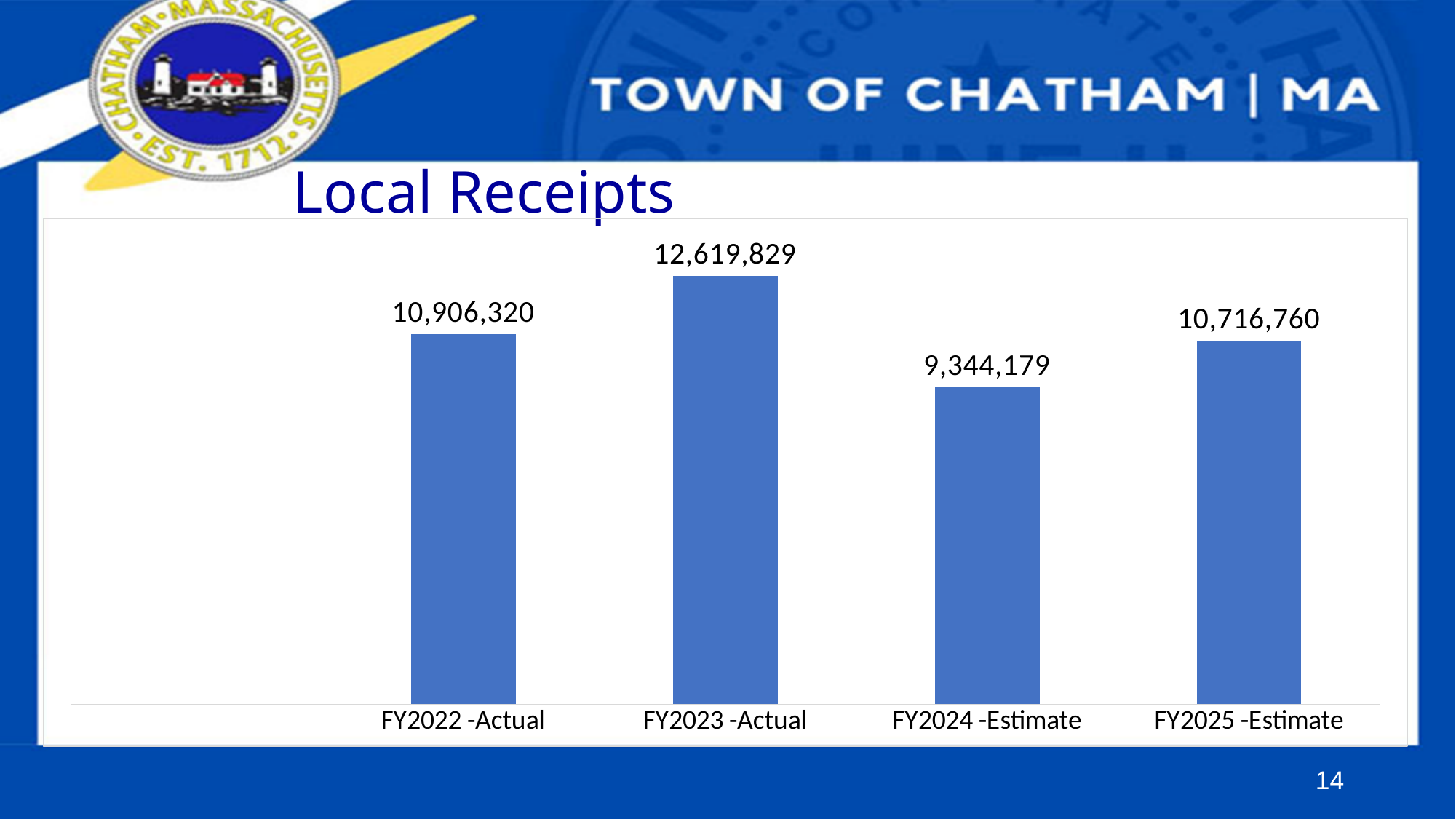
What kind of chart is shown on the slide? bar chart What is the difference between the values for FY2023 -Actual and FY2022 -Actual? 1,713,509 Which is larger, the value for FY2022 -Actual or FY2025 -Estimate? FY2022 -Actual Which category has the highest value? FY2023 -Actual Does the value rise or fall from FY2023 -Actual to FY2024 -Estimate? fall Which category has the lowest value? FY2024 -Estimate What is the value for FY2024 -Estimate? 9,344,179 What is the value for FY2025 -Estimate? 10,716,760 How many categories are shown on the x axis? 4 What is the value for FY2023 -Actual? 12,619,829 What is the difference between the values for FY2025 -Estimate and FY2024 -Estimate? 1,372,581 What is the value for FY2022 -Actual? 10,906,320